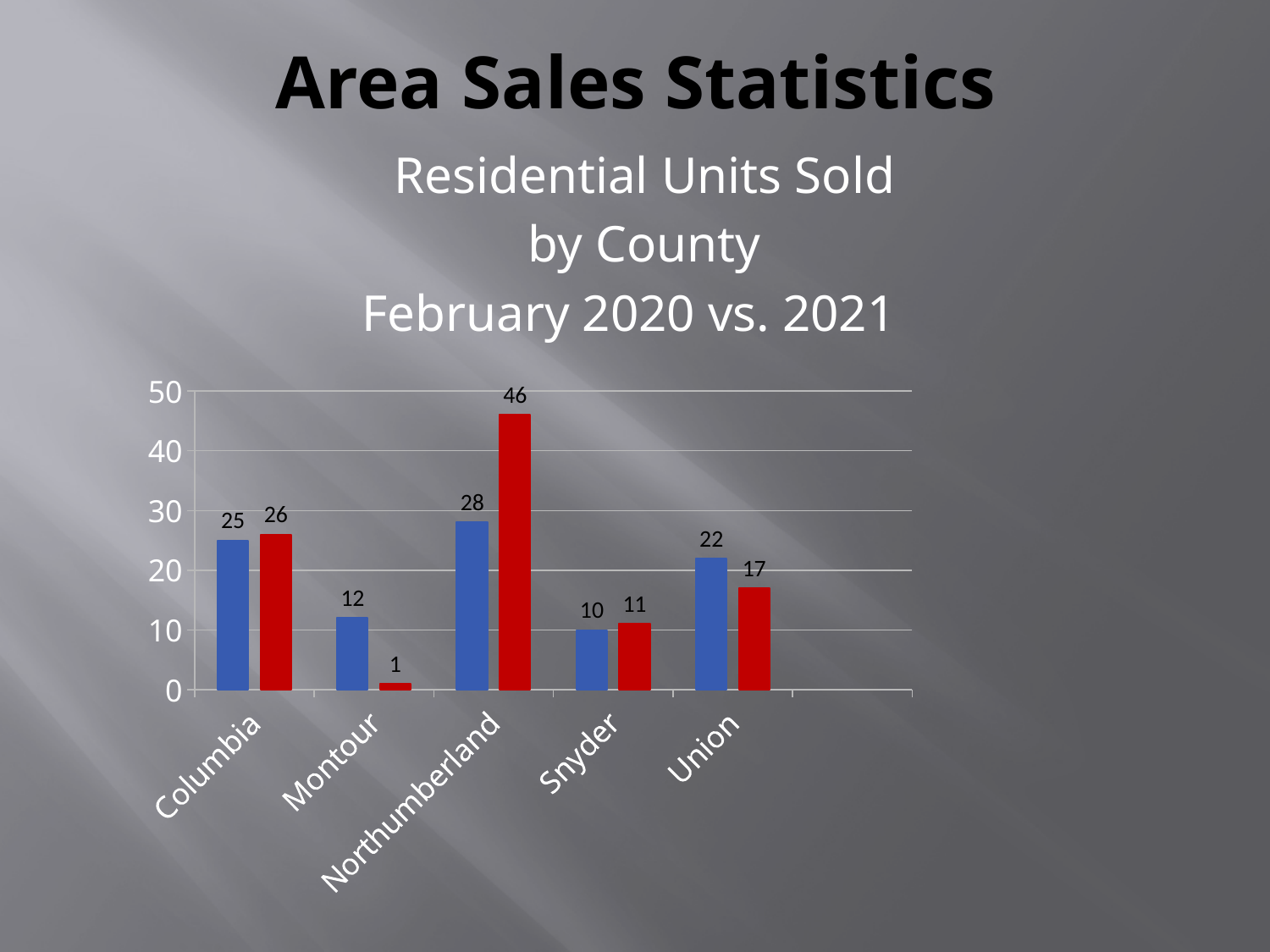
What kind of chart is shown on the slide? bar chart What is the difference between the blue and red bars for Union? 5 What is the value of the red bar for Northumberland? 46 What is the value of the red bar for Montour? 1 What is the value of the blue bar for Columbia? 25 Which county has the highest red bar? Northumberland Which county has the lowest blue bar? Snyder What is the value of the blue bar for Union? 22 For Montour, which bar is larger, blue or red? blue What is the difference between the red and blue bars for Northumberland? 18 What is the title of the chart? Residential Units Sold by County February 2020 vs. 2021 How many counties are shown on the x axis? 5